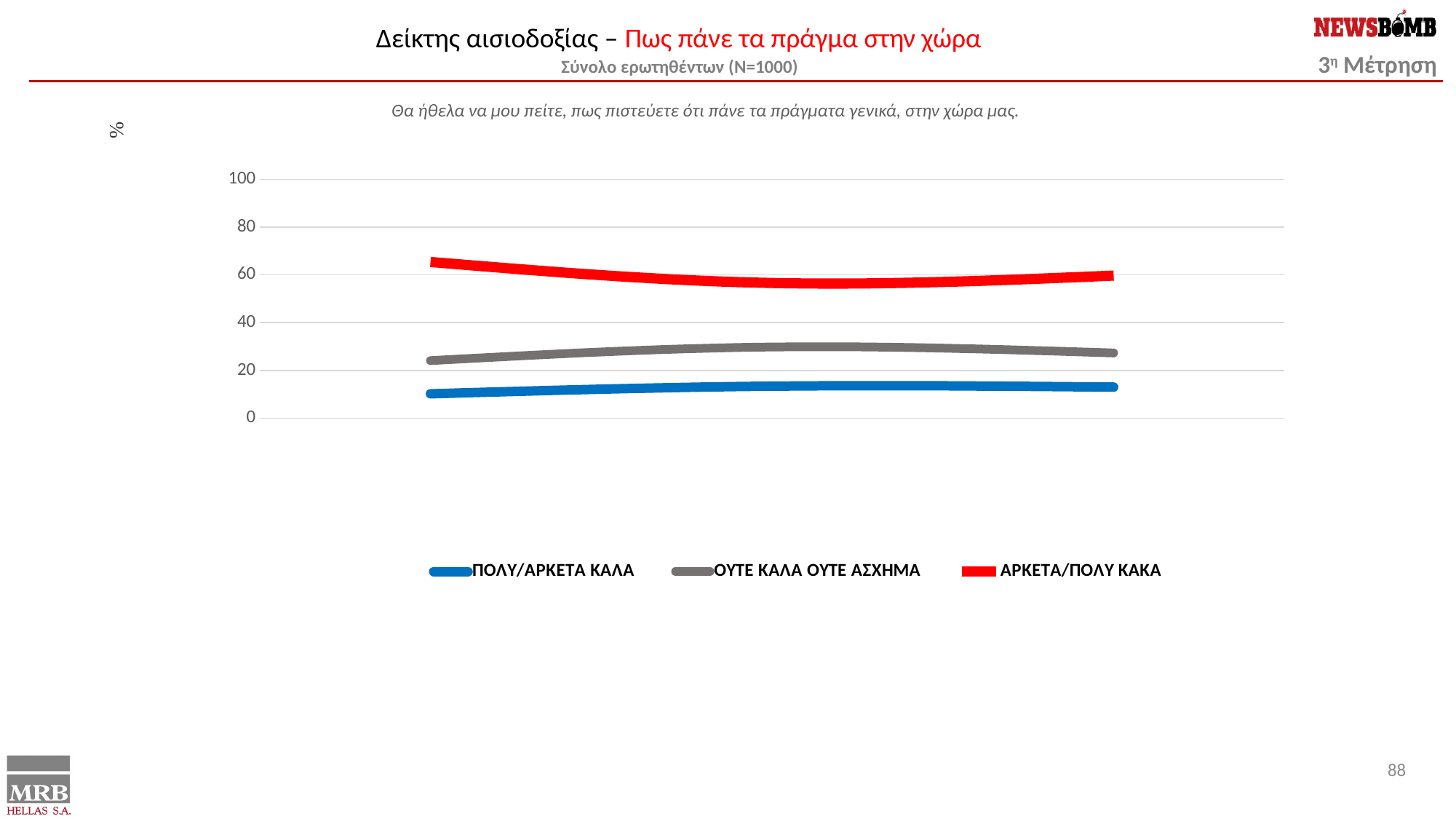
Which series is plotted with the red line? ΑΡΚΕΤΑ/ΠΟΛΥ ΚΑΚΑ Is the value of ΟΥΤΕ ΚΑΛΑ ΟΥΤΕ ΑΣΧΗΜΑ at the end of the line greater or less than 40? less Does the ΠΟΛΥ/ΑΡΚΕΤΑ ΚΑΛΑ line rise or fall from left to right? rise Is the value of ΟΥΤΕ ΚΑΛΑ ΟΥΤΕ ΑΣΧΗΜΑ at the start of the line greater or less than 20? greater At the end of the lines, which is larger: ΑΡΚΕΤΑ/ΠΟΛΥ ΚΑΚΑ or ΟΥΤΕ ΚΑΛΑ ΟΥΤΕ ΑΣΧΗΜΑ? ΑΡΚΕΤΑ/ΠΟΛΥ ΚΑΚΑ Which series has the highest values across the whole chart? ΑΡΚΕΤΑ/ΠΟΛΥ ΚΑΚΑ How many series does the legend list? 3 Is the value of ΑΡΚΕΤΑ/ΠΟΛΥ ΚΑΚΑ at the start of the line greater or less than 60? greater What kind of chart is shown on the slide? line chart Which series has the lowest values across the whole chart? ΠΟΛΥ/ΑΡΚΕΤΑ ΚΑΛΑ Which series is plotted with the blue line? ΠΟΛΥ/ΑΡΚΕΤΑ ΚΑΛΑ